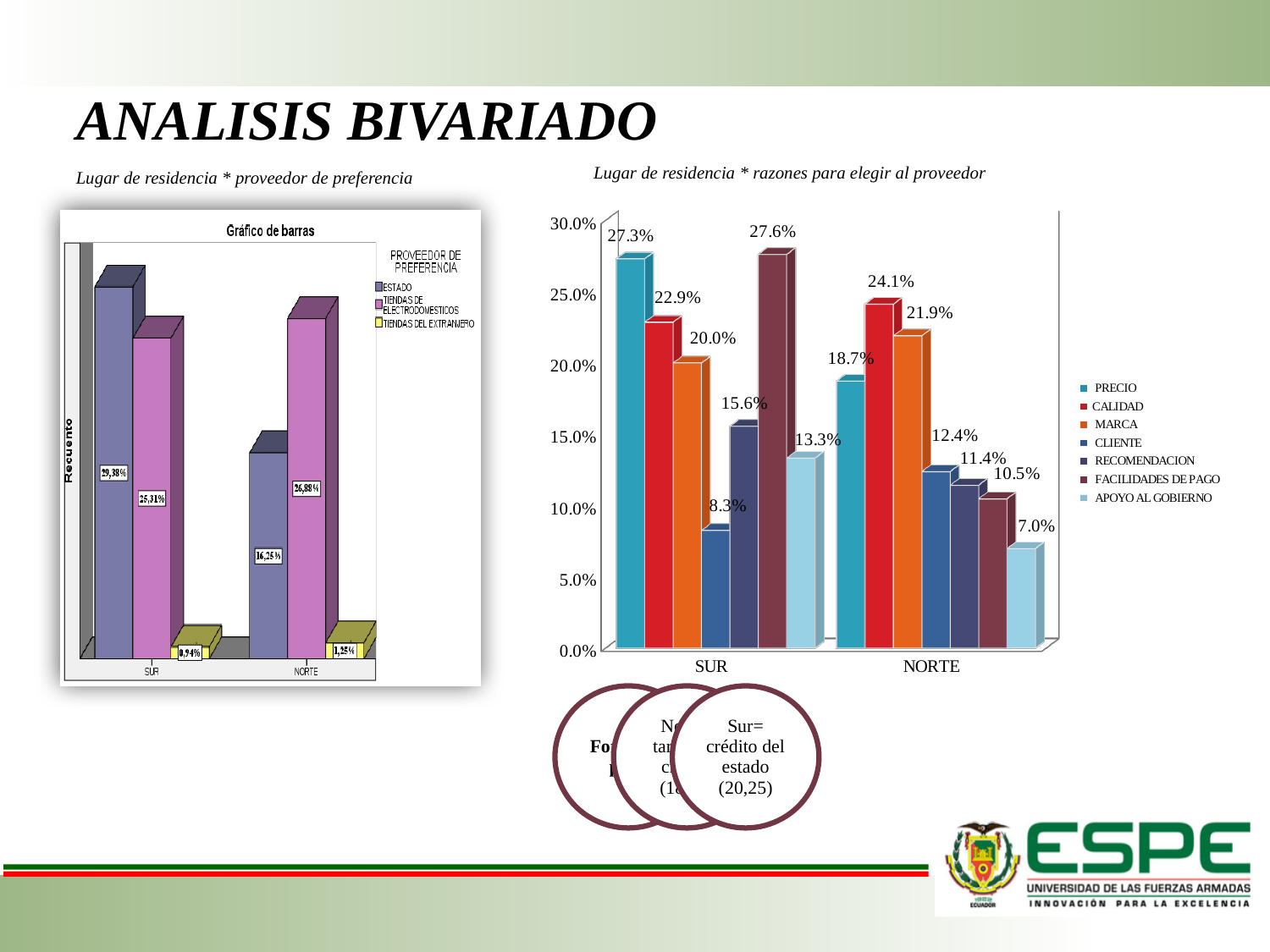
In the left chart (Gráfico de barras), which provider has the highest value for NORTE? TIENDAS DE ELECTRODOMESTICOS In the left chart (Gráfico de barras), what is the value for TIENDAS DEL EXTRANJERO in NORTE? 1,25% In the right chart (Lugar de residencia * razones para elegir al proveedor), how many series does the legend list? 7 In the right chart (Lugar de residencia * razones para elegir al proveedor), what is the difference between MARCA in NORTE and MARCA in SUR? 1.9% What kind of chart is the left chart (Gráfico de barras)? Bar chart In the right chart (Lugar de residencia * razones para elegir al proveedor), what is the value for CALIDAD in NORTE? 24.1% In the right chart (Lugar de residencia * razones para elegir al proveedor), which is larger: CLIENTE in SUR or CLIENTE in NORTE? CLIENTE in NORTE In the right chart (Lugar de residencia * razones para elegir al proveedor), which reason has the lowest value for NORTE? APOYO AL GOBIERNO In the right chart (Lugar de residencia * razones para elegir al proveedor), what is the value for RECOMENDACION in NORTE? 11.4% In the left chart (Gráfico de barras), what is the value for ESTADO in SUR? 29,38% In the right chart (Lugar de residencia * razones para elegir al proveedor), what is the value for PRECIO in SUR? 27.3% In the right chart (Lugar de residencia * razones para elegir al proveedor), which reason has the highest value for SUR? FACILIDADES DE PAGO